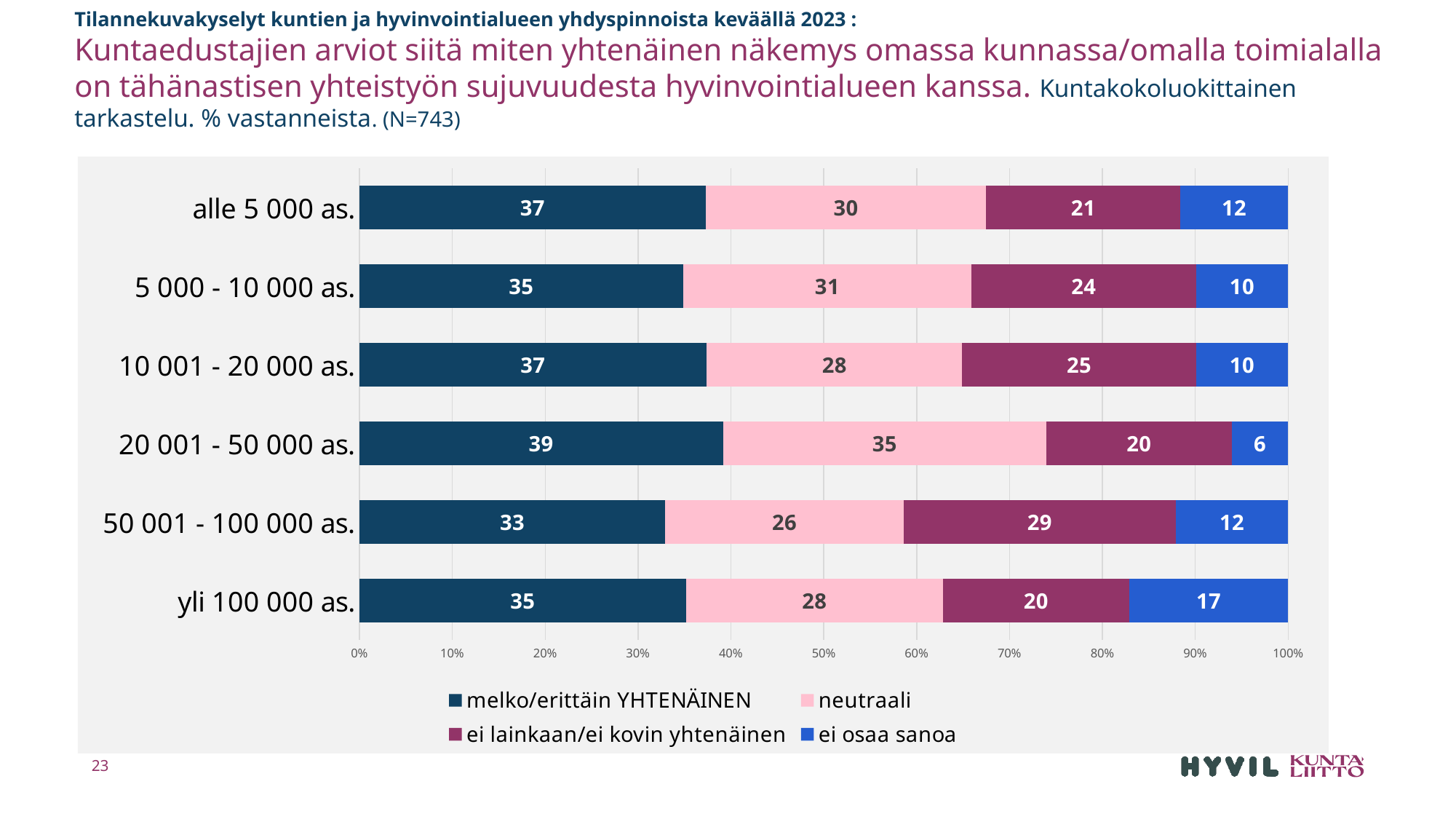
What is the neutraali value for the 50 001 - 100 000 as. category? 26 Which category has the highest ei lainkaan/ei kovin yhtenäinen value? 50 001 - 100 000 as. How many municipality size categories are shown in the chart? 6 What kind of chart is shown on the slide? Stacked bar chart Which has a larger ei lainkaan/ei kovin yhtenäinen value: 5 000 - 10 000 as. or 10 001 - 20 000 as.? 10 001 - 20 000 as. How many series does the legend list? 4 What is the value of melko/erittäin YHTENÄINEN for the 20 001 - 50 000 as. category? 39 Which category has the highest melko/erittäin YHTENÄINEN value? 20 001 - 50 000 as. What is the value of ei osaa sanoa for the yli 100 000 as. category? 17 What is the difference between the neutraali values for 20 001 - 50 000 as. and 50 001 - 100 000 as.? 9 Which category has the lowest ei osaa sanoa value? 20 001 - 50 000 as. What is the ei lainkaan/ei kovin yhtenäinen value for the alle 5 000 as. category? 21